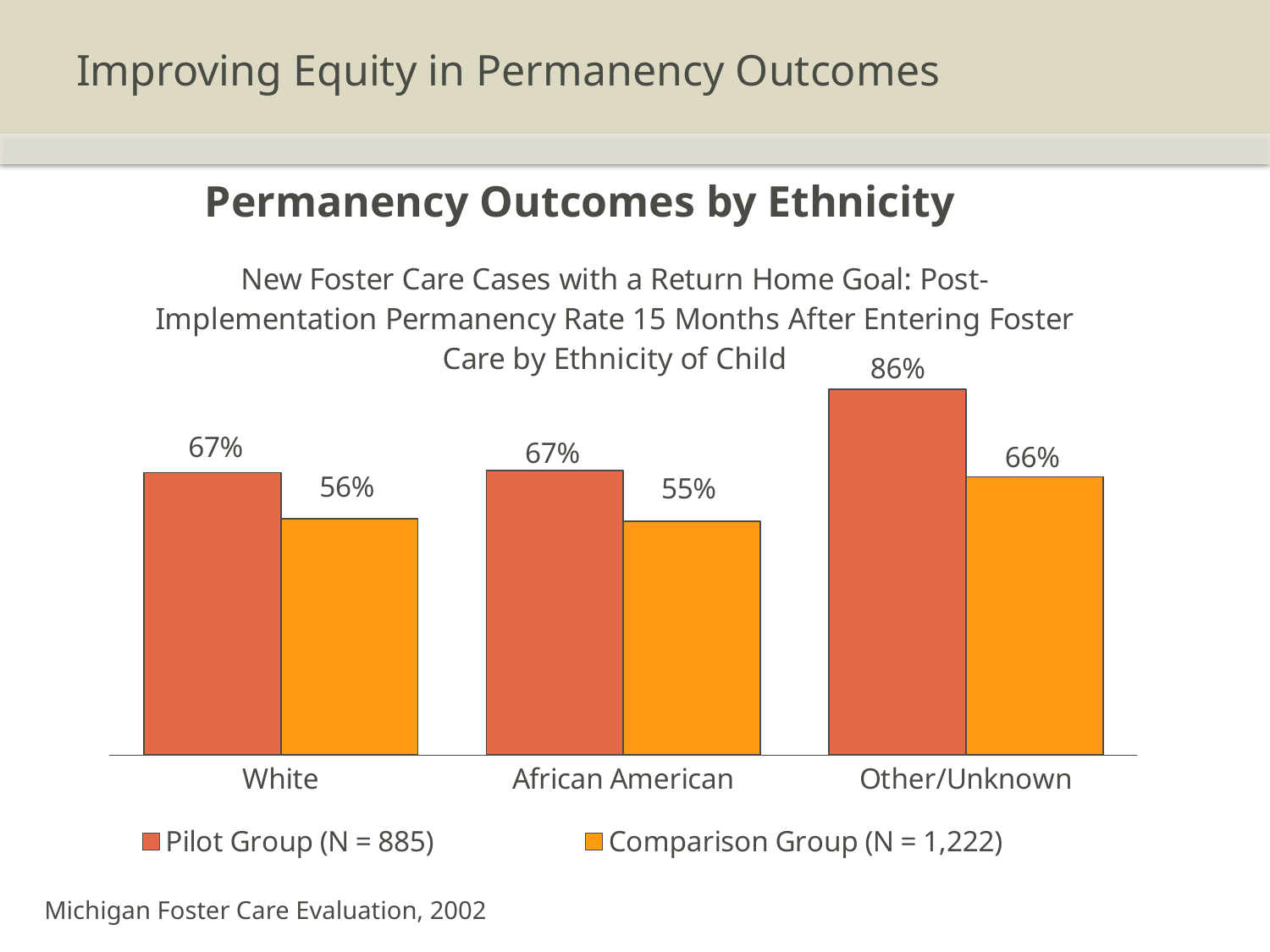
Which ethnicity category has the lowest Comparison Group permanency rate? African American Which is larger for African American children: the Pilot Group rate or the Comparison Group rate? Pilot Group How many series does the legend list? 2 What is the Pilot Group permanency rate for White children? 67% What is the Pilot Group permanency rate for the Other/Unknown category? 86% How many ethnicity categories are shown on the x axis? 3 What is the Comparison Group permanency rate for African American children? 55% What is the difference between the Pilot Group and Comparison Group rates for White children? 11% What is the sample size (N) of the Comparison Group shown in the legend? 1,222 What kind of chart is shown on the slide? Bar chart Which ethnicity category has the highest Pilot Group permanency rate? Other/Unknown What is the difference between the Pilot Group and Comparison Group rates for Other/Unknown children? 20%